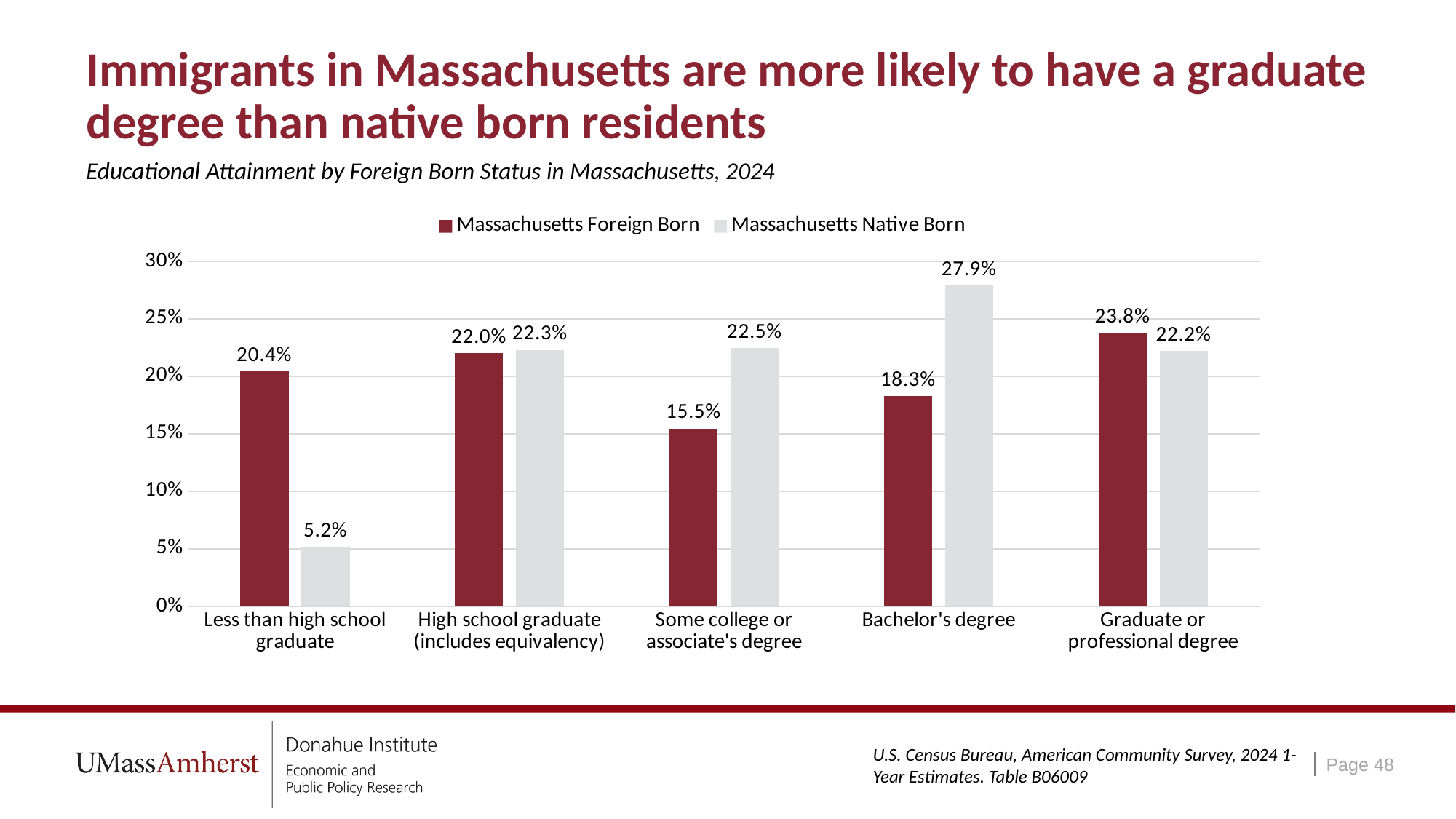
In the Some college or associate's degree category, which series has the larger value? Massachusetts Native Born Which category has the lowest value for Massachusetts Native Born? Less than high school graduate What type of chart is shown on the slide? Bar chart What is the difference between the Foreign Born and Native Born values for Less than high school graduate? 15.2% How many series does the legend list? 2 What is the difference between the Native Born and Foreign Born values for Bachelor's degree? 9.6% What is the value for Massachusetts Foreign Born in the Graduate or professional degree category? 23.8% What percentage of Massachusetts Foreign Born residents have less than a high school graduate education? 20.4% Is the Massachusetts Native Born value for Bachelor's degree greater or less than 25%? greater How many education categories are shown on the x axis? 5 What is the value for Massachusetts Native Born in the Bachelor's degree category? 27.9% Which category has the highest value for Massachusetts Foreign Born? Graduate or professional degree